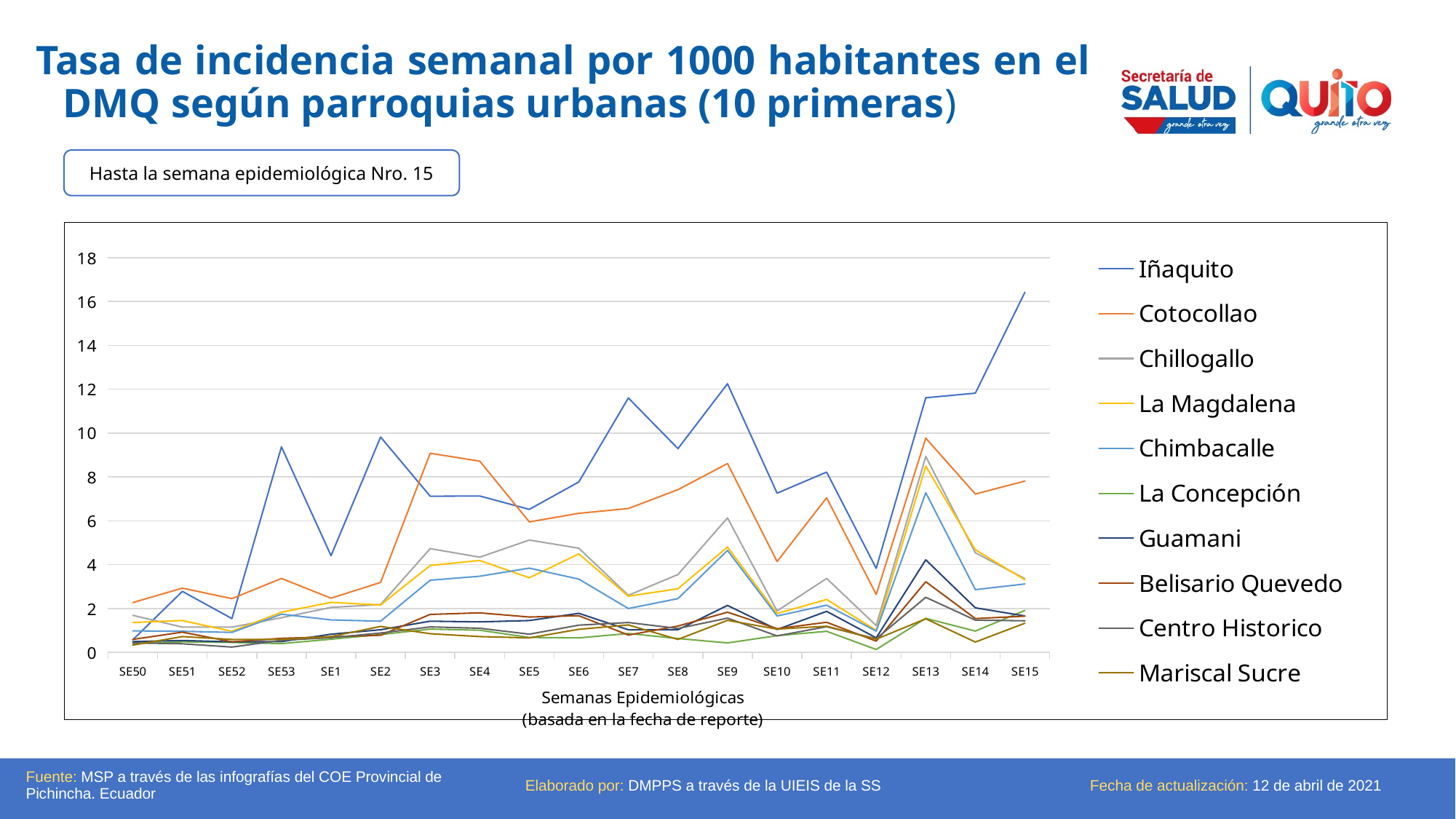
At SE3, which is larger: the value for Cotocollao or the value for Iñaquito? Cotocollao How many series does the legend list? 10 In which week does the Iñaquito series reach its highest value? SE15 Does the Iñaquito series rise or fall from SE12 to SE15? rise Which series reaches the highest value on the chart? Iñaquito What kind of chart is shown on the slide? line chart Is the value for Iñaquito at SE15 greater or less than 14? greater Is the value for Cotocollao at SE12 greater or less than 4? less Is the value for Iñaquito at SE1 greater or less than 6? less How many epidemiological weeks are plotted along the x axis? 19 What is the label of the x axis? Semanas Epidemiológicas (basada en la fecha de reporte)